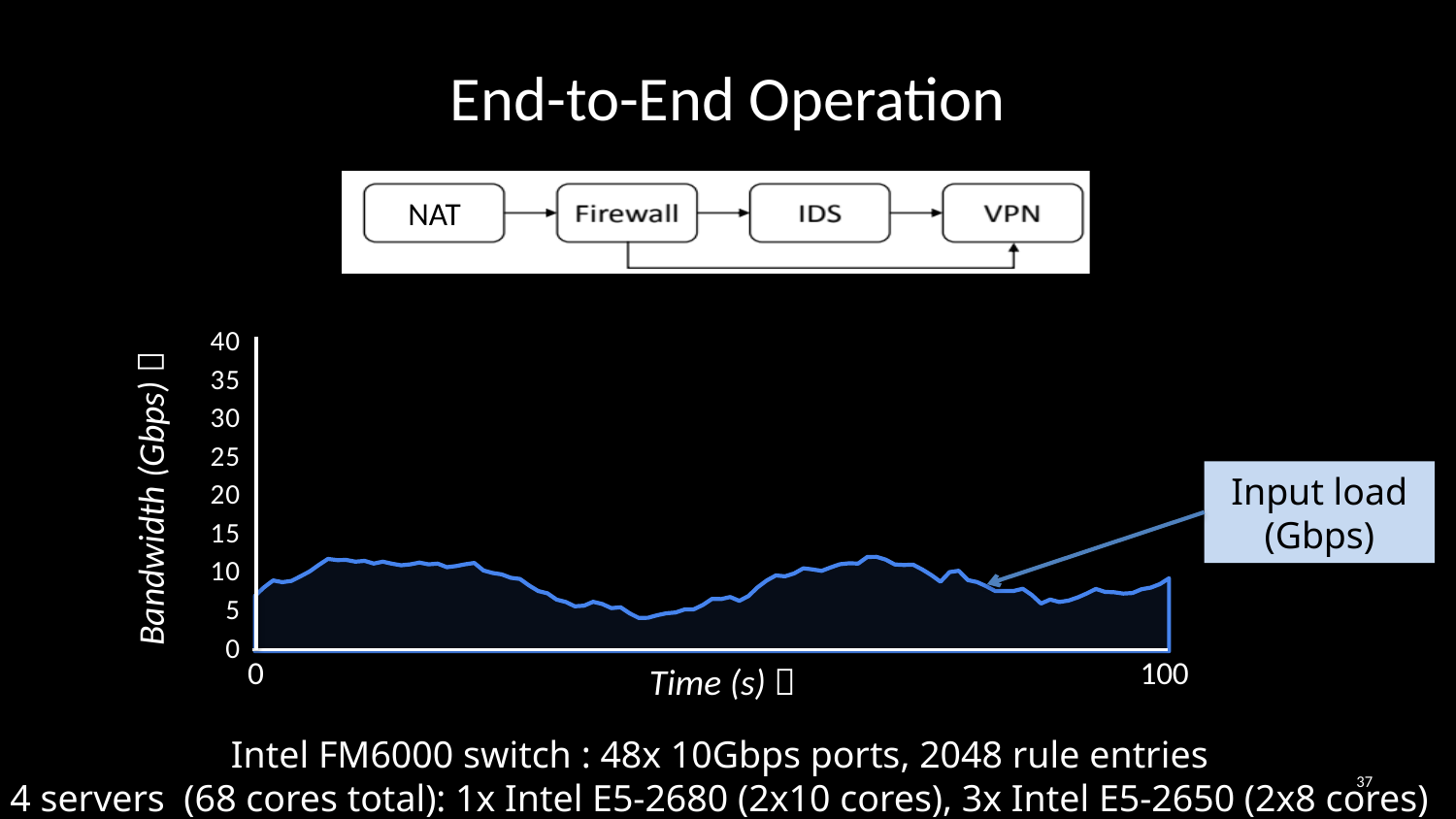
How many data series are plotted in the chart? 1 What is the highest value shown on the y axis of the chart? 40 Does the input load stay below 15 Gbps for the entire time range shown? yes Is the input load at time 0 s greater or less than 10 Gbps? less What is the label of the y axis of the chart? Bandwidth (Gbps) What does the callout label in the chart say the plotted series represents? Input load (Gbps) Is the input load at any point in the chart greater or less than 20 Gbps? less What is the label of the x axis of the chart? Time (s) What is the largest value shown on the x axis of the chart? 100 What kind of chart is shown on the slide? area chart